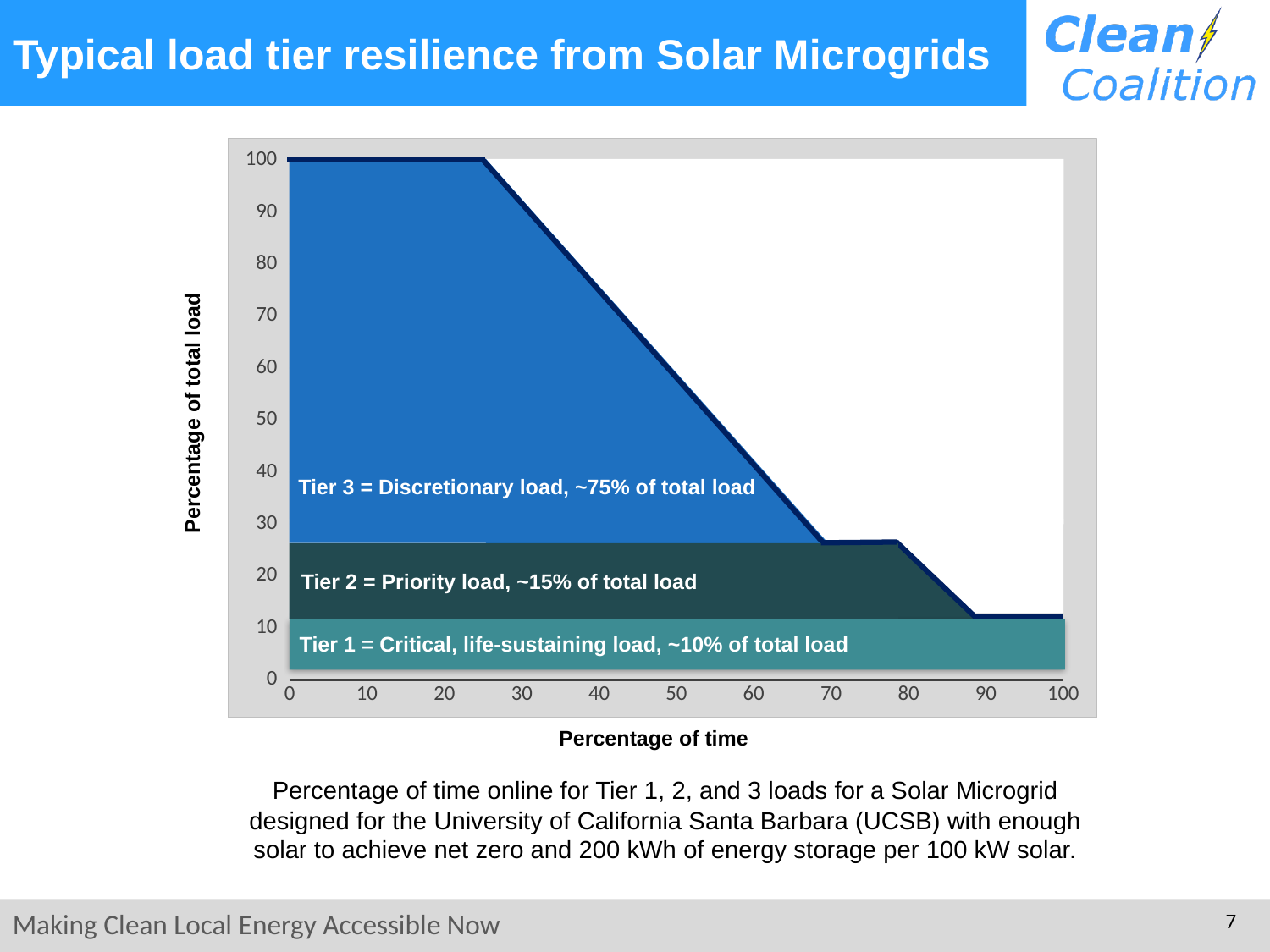
Is the percentage of total load at 50% of time greater or less than 50? greater How many load tiers are labelled on the chart? 3 According to the label on the chart, what share of total load is Tier 2 (Priority load)? ~15% According to the label on the chart, what share of total load is Tier 3 (Discretionary load)? ~75% What kind of chart is shown on the slide? Area chart Is the percentage of total load at 10% of time greater or less than 90? greater Is the percentage of total load at 100% of time greater or less than 20? less What is the label of the x axis? Percentage of time Does the percentage of total load rise or fall as the percentage of time increases along the x axis? Fall According to the label on the chart, what share of total load is Tier 1 (Critical, life-sustaining load)? ~10% Which is larger: the percentage of total load at 20% of time or at 80% of time? 20% of time What is the title of the chart on the slide? Typical load tier resilience from Solar Microgrids